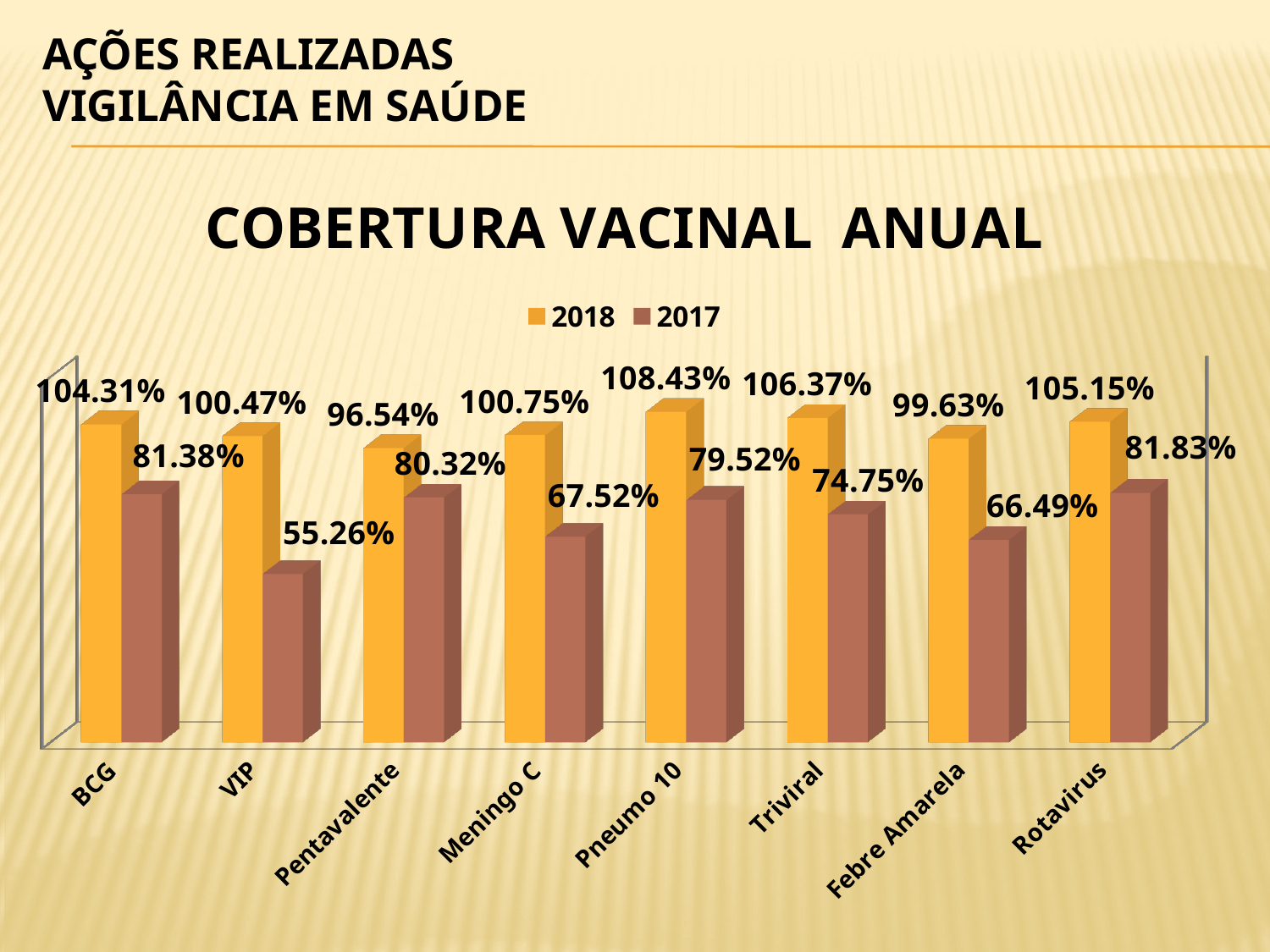
What is the 2017 value for Febre Amarela? 66.49% What is the 2018 vaccination coverage for BCG? 104.31% Which vaccine has the highest 2018 coverage? Pneumo 10 What is the 2017 vaccination coverage for VIP? 55.26% How many series does the legend list? 2 What type of chart is shown? Bar chart Which vaccine has the lowest 2018 coverage? Pentavalente Which is larger: the 2017 value for BCG or the 2017 value for Rotavirus? Rotavirus Which vaccine has the lowest 2017 coverage? VIP What is the difference between the 2018 and 2017 values for Rotavirus? 23.32% What is the 2018 value for Pneumo 10? 108.43% How many vaccines are shown on the x axis? 8